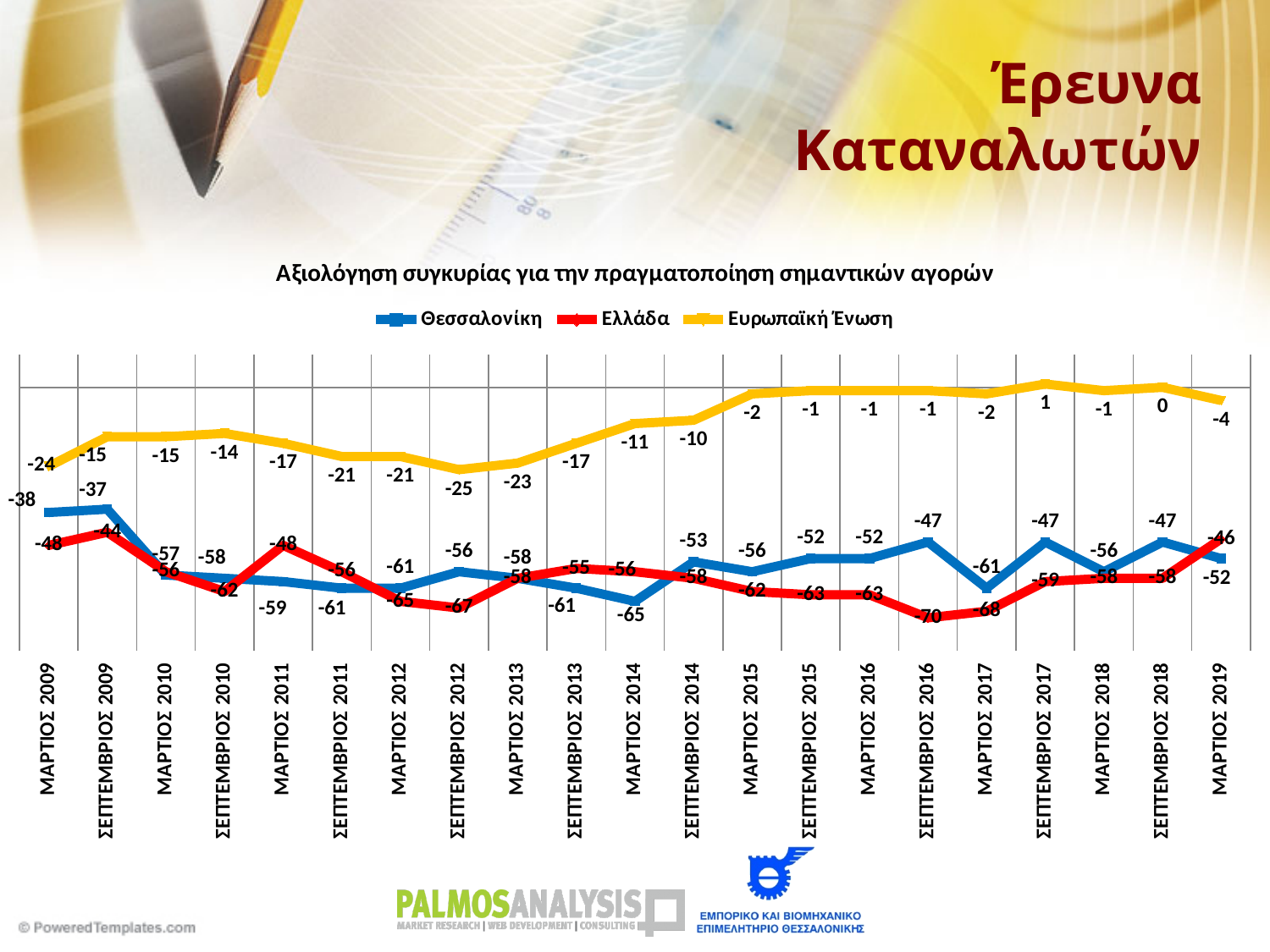
In which period does Ευρωπαϊκή Ένωση reach its highest value? ΣΕΠΤΕΜΒΡΙΟΣ 2017 In ΜΑΡΤΙΟΣ 2019, which is higher: Ελλάδα or Θεσσαλονίκη? Ελλάδα In which period does Ελλάδα reach its lowest value? ΣΕΠΤΕΜΒΡΙΟΣ 2016 Which series is drawn in yellow? Ευρωπαϊκή Ένωση What is the value for Ελλάδα in ΣΕΠΤΕΜΒΡΙΟΣ 2016? -70 What kind of chart is shown on the slide? line chart What is the value for Ευρωπαϊκή Ένωση in ΜΑΡΤΙΟΣ 2019? -4 How many time points are plotted along the x axis? 21 What is the value for Θεσσαλονίκη in ΜΑΡΤΙΟΣ 2009? -38 What is the value for Ευρωπαϊκή Ένωση in ΜΑΡΤΙΟΣ 2009? -24 What is the difference between the Ευρωπαϊκή Ένωση values in ΜΑΡΤΙΟΣ 2019 and ΜΑΡΤΙΟΣ 2009? 20 How many series does the legend list? 3